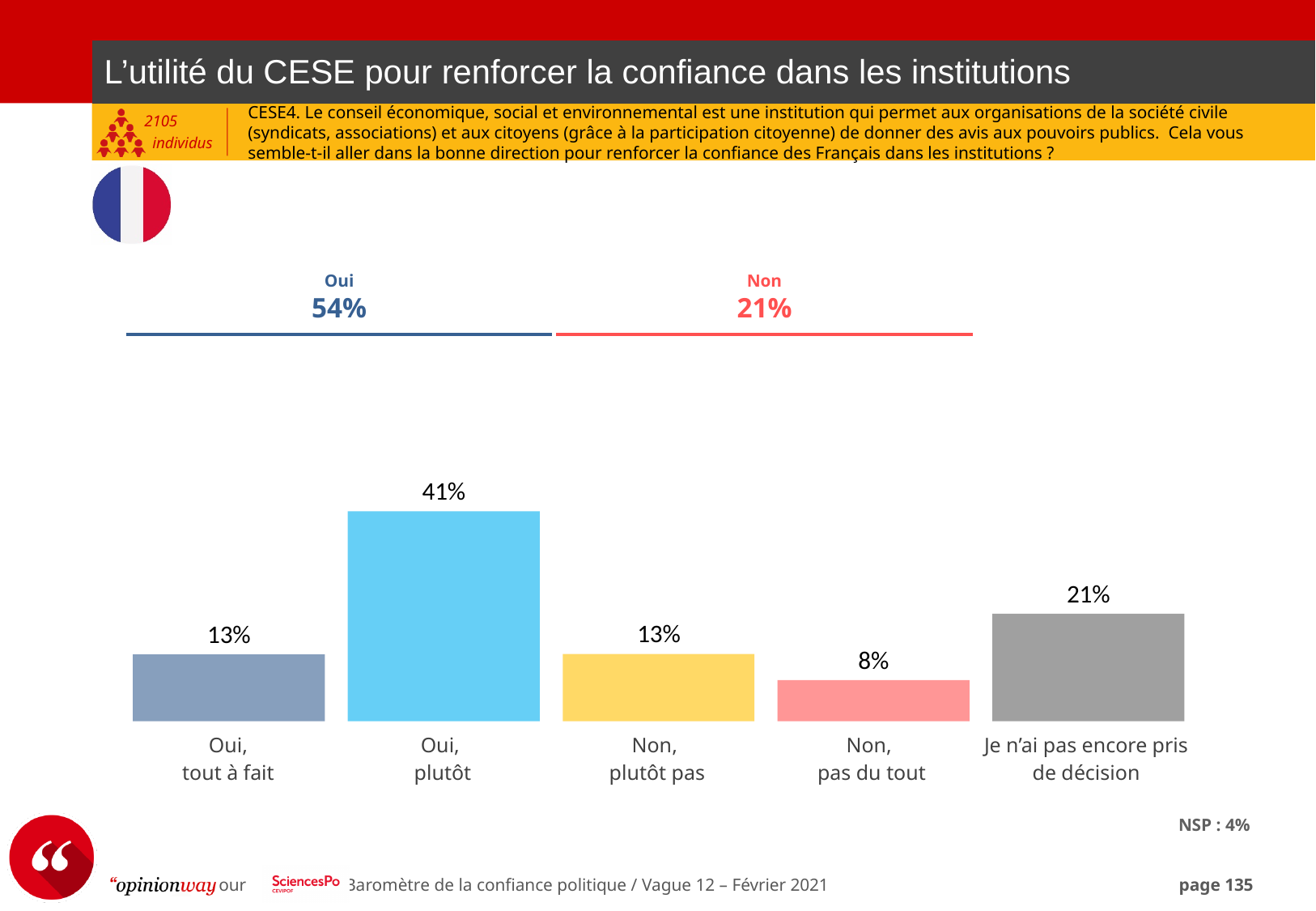
How many categories are shown in the bar chart? 5 Which category has the highest value? Oui, plutôt What is the value for "Je n'ai pas encore pris de décision"? 21% What is the value for "Oui, plutôt"? 41% What kind of chart is shown on the slide? Bar chart What is the value for "Non, pas du tout"? 8% What is the combined "Oui" total shown above the chart? 54% What is the NSP (don't know) share shown on the slide? 4% What is the value for "Oui, tout à fait"? 13% Which category has the lowest value? Non, pas du tout What is the difference between "Oui, plutôt" and "Je n'ai pas encore pris de décision"? 20 percentage points Which is larger, "Non, plutôt pas" or "Non, pas du tout"? Non, plutôt pas